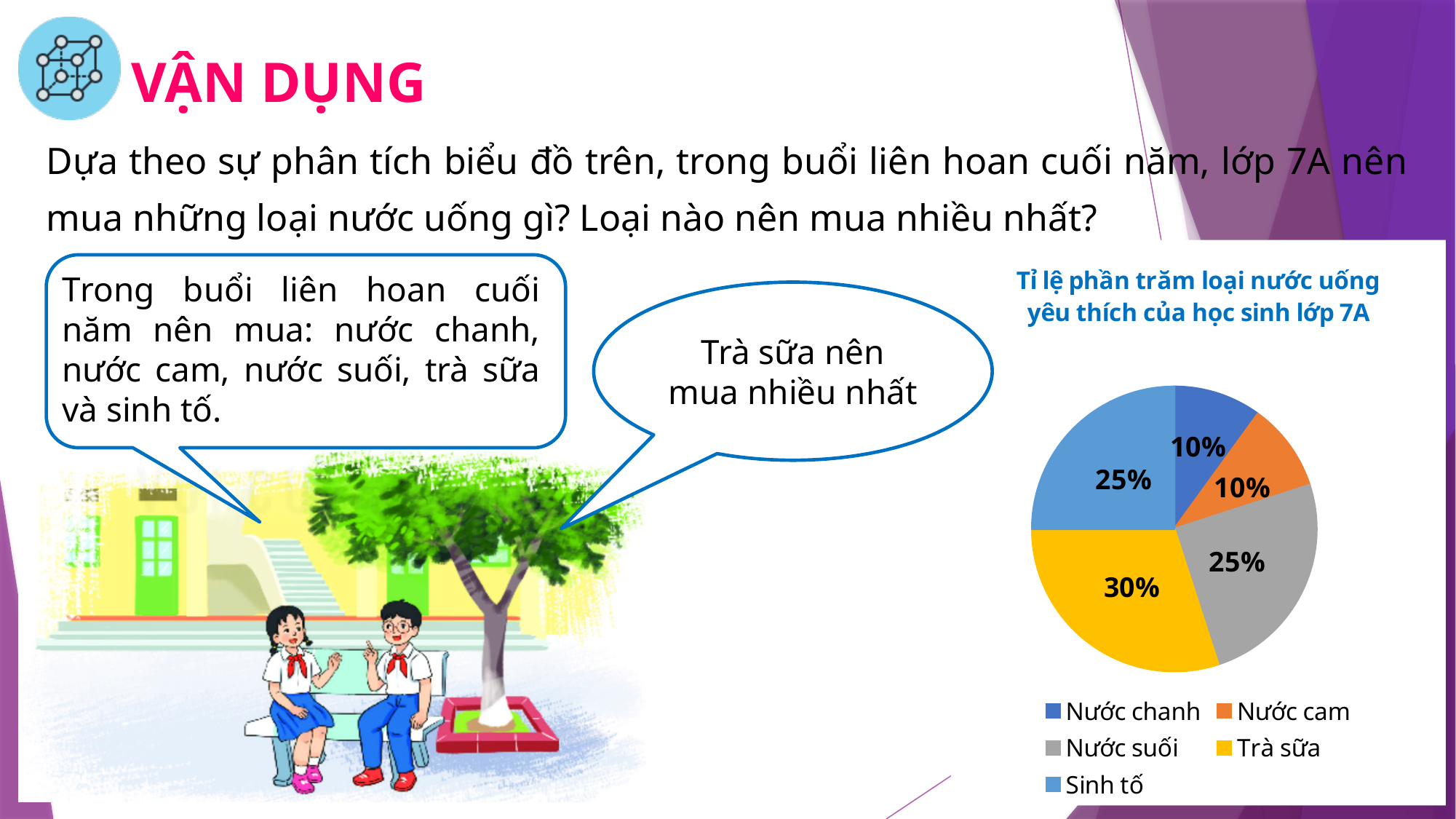
What percentage of the pie chart is Trà sữa? 30% What is the difference in percentage between Sinh tố and Nước cam? 15% What is the title of the chart? Tỉ lệ phần trăm loại nước uống yêu thích của học sinh lớp 7A What percentage of the pie chart is Nước cam? 10% Which drink has the largest share of the pie chart? Trà sữa What is the difference in percentage between Trà sữa and Nước suối? 5% Which has a larger share, Trà sữa or Sinh tố? Trà sữa What percentage of the pie chart is Sinh tố? 25% How many categories does the pie chart show? 5 What percentage of the pie chart is Nước chanh? 10% What type of chart is shown on the slide? Pie chart What percentage of the pie chart is Nước suối? 25%